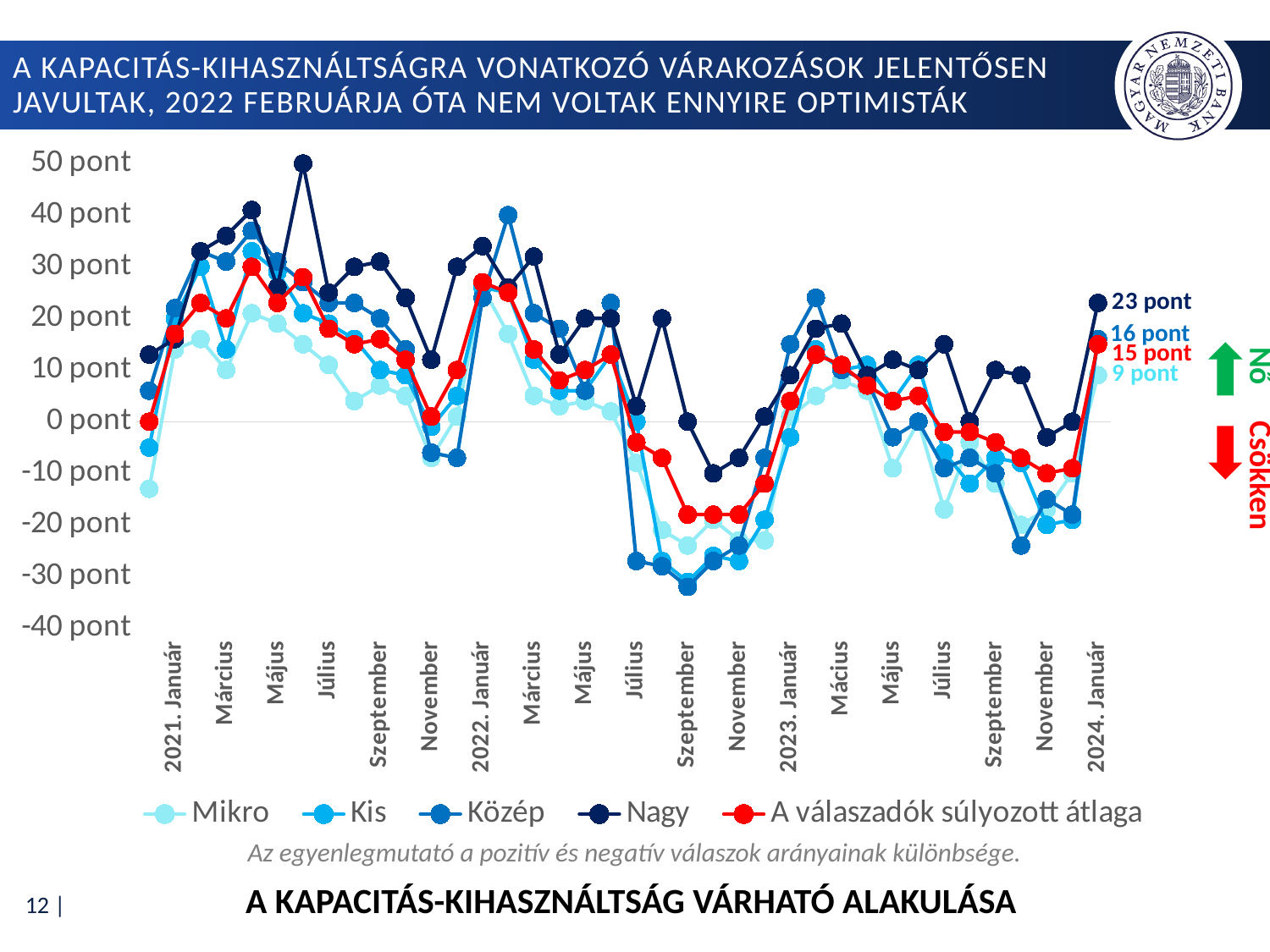
What is the difference between the Nagy value and A válaszadók súlyozott átlaga in 2024. Január? 8 pont Which series is drawn in red? A válaszadók súlyozott átlaga Which series has the highest value in 2024. Január? Nagy What is the difference between the Nagy and Mikro values in 2024. Január? 14 pont How many series does the legend list? 5 Does the value for A válaszadók súlyozott átlaga rise or fall from 2022. Január to 2022. Szeptember? fall Which series has the lowest value in 2024. Január? Mikro What kind of chart is shown on the slide? line chart What is the value for A válaszadók súlyozott átlaga in 2024. Január? 15 pont Is the value for A válaszadók súlyozott átlaga in 2022. Szeptember greater or less than -10 pont? less What is the value for Nagy in 2024. Január? 23 pont What is the value for Mikro in 2024. Január? 9 pont